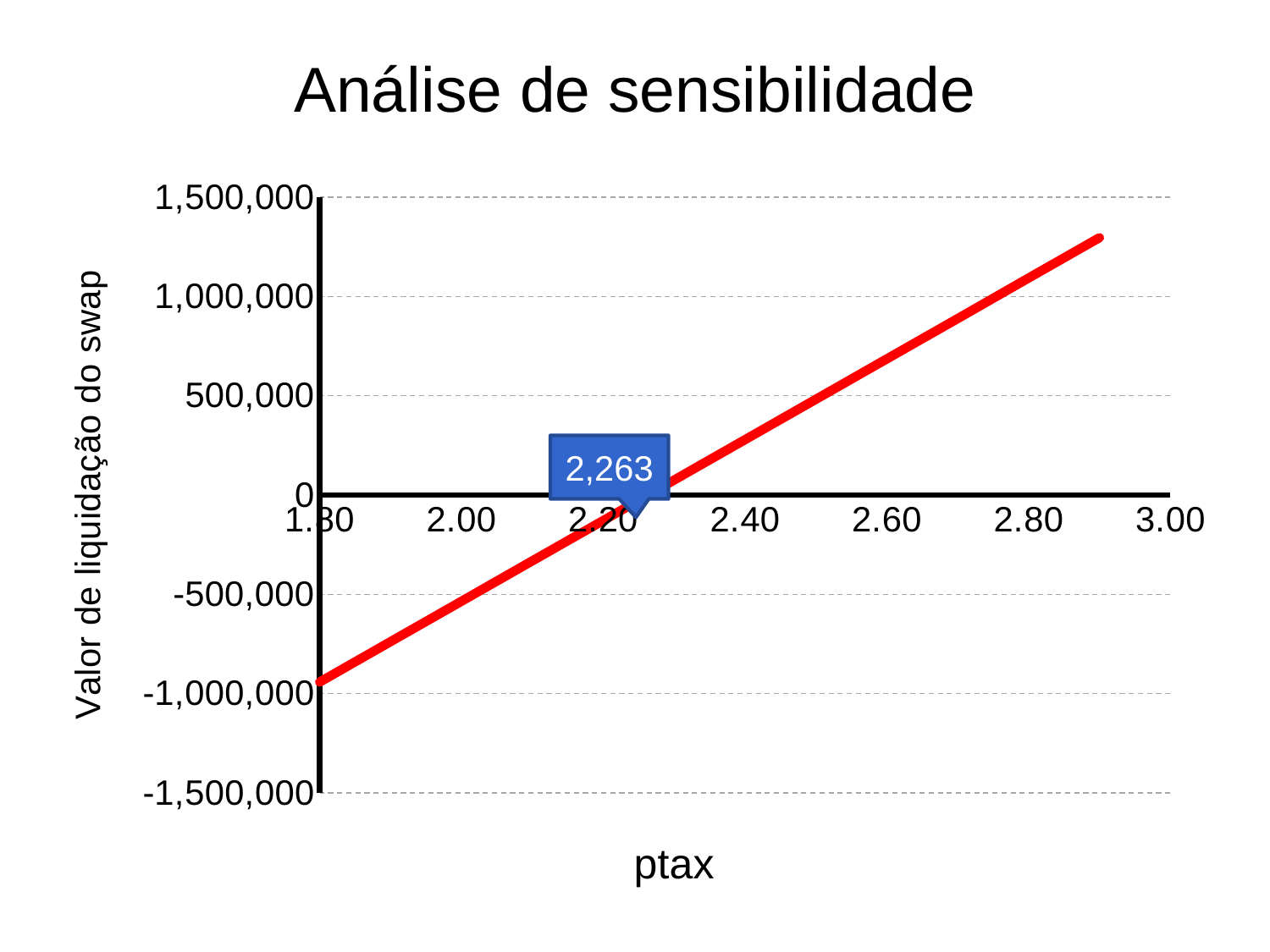
What is the label of the x axis? ptax Which ptax value has the higher swap liquidation value, 2.00 or 2.80? 2.80 Does the value of the swap liquidation rise or fall as ptax increases? rises Is the swap liquidation value at ptax 2.40 greater or less than 0? greater Is the swap liquidation value at ptax 2.90 greater or less than 1,000,000? greater Is the swap liquidation value at ptax 2.20 greater or less than 0? less How many tick labels are shown on the x axis? 7 What value is printed in the callout label on the chart? 2,263 What kind of chart is shown on the slide? line chart What is the title of the chart? Análise de sensibilidade